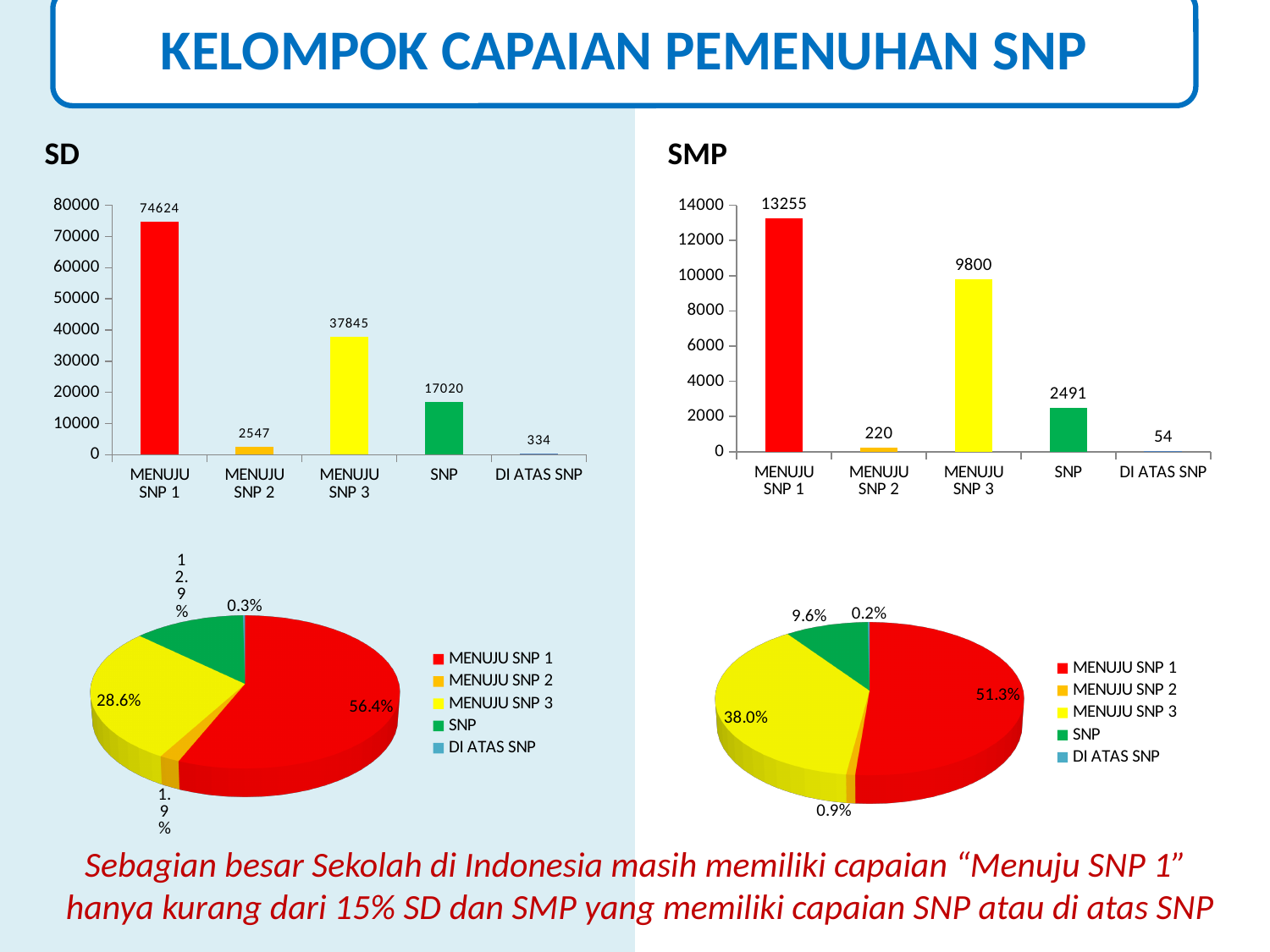
How many entries does the legend of the SMP pie chart list? 5 In the SMP pie chart, what share does MENUJU SNP 3 have? 38.0% In the SD bar chart, what is the difference between the values for MENUJU SNP 3 and SNP? 20825 In the SMP bar chart, what is the difference between the values for MENUJU SNP 1 and MENUJU SNP 3? 3455 In the SD bar chart, what is the value for MENUJU SNP 1? 74624 In the SMP bar chart, what is the value for MENUJU SNP 3? 9800 In the SMP bar chart, which category has the lowest value? DI ATAS SNP In the SMP bar chart, which is larger, the value for SNP or the value for MENUJU SNP 2? SNP How many categories are shown in the SD bar chart? 5 In the SD pie chart, what share does SNP have? 12.9% What kind of chart is the SD chart at the top left of the slide? bar chart In the SD bar chart, which category has the highest value? MENUJU SNP 1